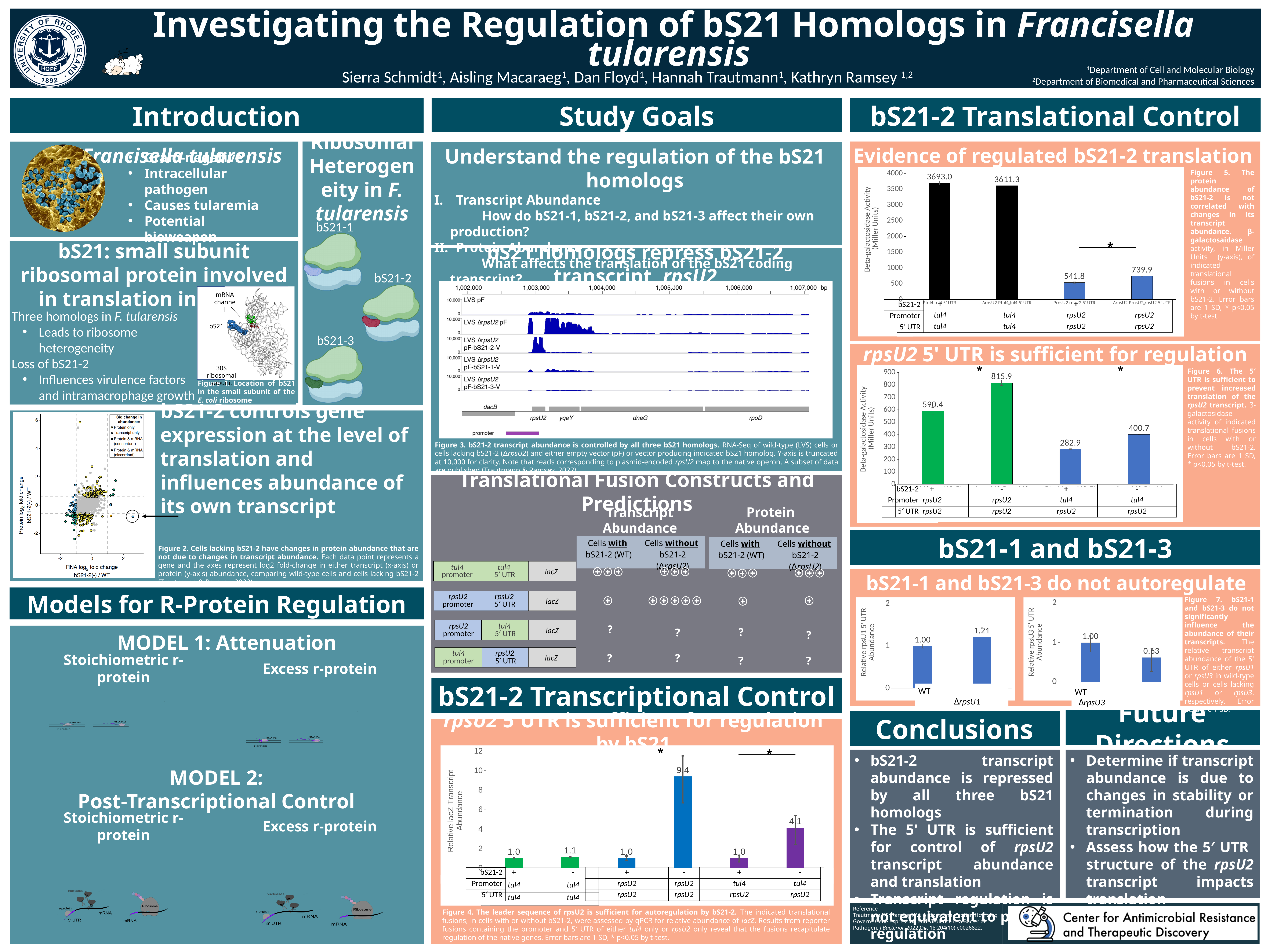
In the Figure 4 chart 'rpsU2 5' UTR is sufficient for regulation by bS21-2' (Transcriptional Control section), how many bars are plotted? 6 In the 'Evidence of regulated bS21-2 translation' chart (Figure 5), what is the highest value shown? 3693.0 In the Figure 4 chart 'rpsU2 5' UTR is sufficient for regulation by bS21-2' (Transcriptional Control section), what is the value for the tul4 promoter / rpsU2 5' UTR fusion without bS21-2? 4.1 In the Figure 4 chart 'rpsU2 5' UTR is sufficient for regulation by bS21-2' (Transcriptional Control section), what is the highest value shown? 9.4 In the Figure 7 chart of relative rpsU3 5' UTR abundance, what is the value for ΔrpsU3? 0.63 In the Figure 6 chart 'rpsU2 5' UTR is sufficient for regulation' (Translational Control section), which fusion has the lowest value? tul4 promoter, rpsU2 5' UTR, with bS21-2 (282.9) In the Figure 6 chart 'rpsU2 5' UTR is sufficient for regulation' (Translational Control section), what is the difference between the two rpsU2 promoter / rpsU2 5' UTR bars (815.9 and 590.4)? 225.5 In the Figure 7 chart of relative rpsU1 5' UTR abundance, which is larger, WT or ΔrpsU1? ΔrpsU1 In the Figure 6 chart 'rpsU2 5' UTR is sufficient for regulation' (Translational Control section), what is the value for the rpsU2 promoter / rpsU2 5' UTR fusion without bS21-2? 815.9 In the 'Evidence of regulated bS21-2 translation' chart (Figure 5), what is the y-axis label? Beta-galactosidase Activity (Miller Units) In the 'Evidence of regulated bS21-2 translation' chart (Figure 5), what is the lowest value shown? 541.8 In the 'Evidence of regulated bS21-2 translation' chart (Figure 5), what is the difference between the two rpsU2 promoter / rpsU2 5' UTR bars (739.9 and 541.8)? 198.1